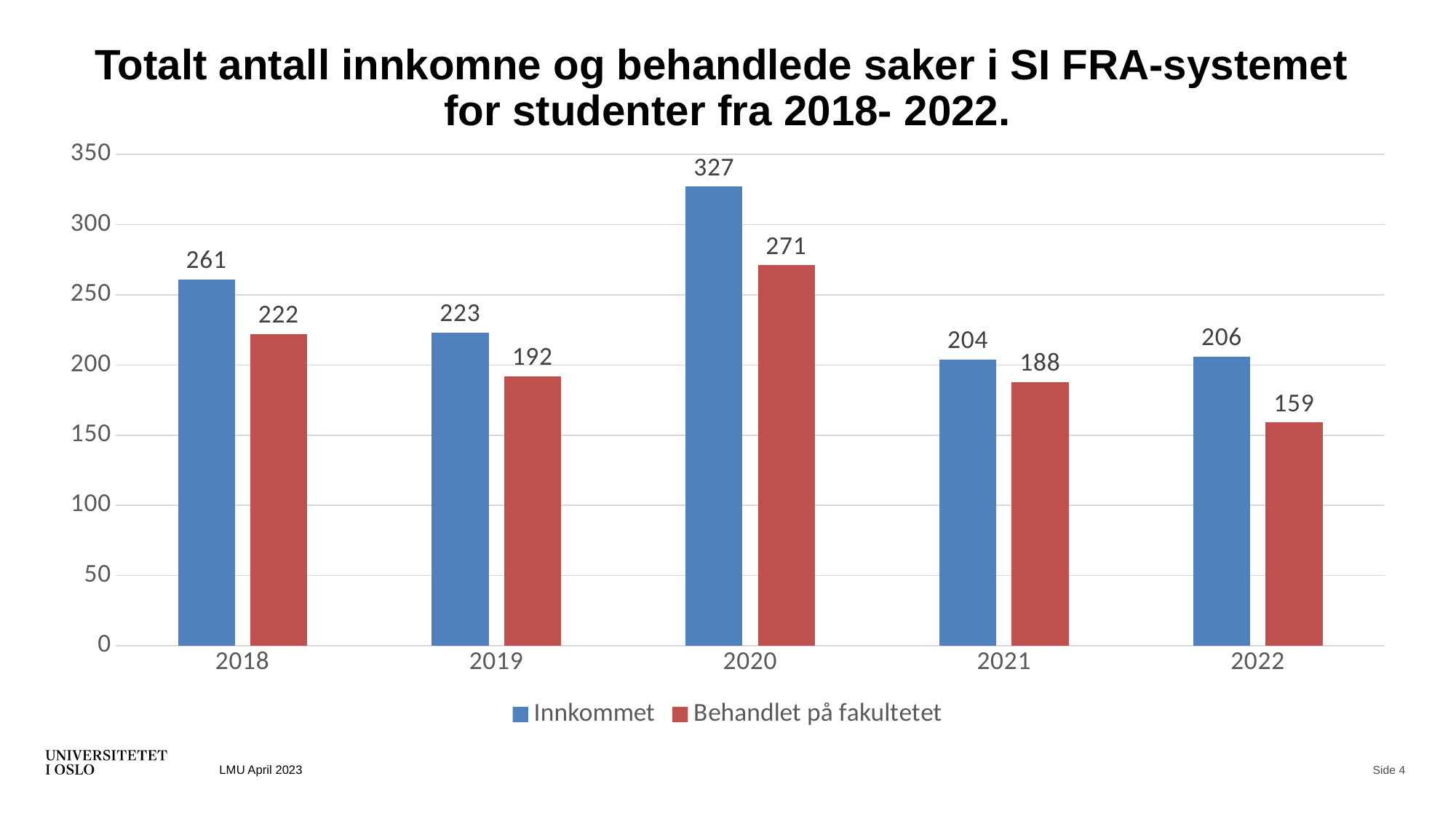
What is the difference between Innkommet and Behandlet på fakultetet in 2020? 56 Which year has the highest Innkommet value? 2020 Which colour represents the Innkommet series? Blue What is the value for Behandlet på fakultetet in 2018? 222 Which is larger: Innkommet in 2018 or Innkommet in 2019? Innkommet in 2018 What is the value for Innkommet in 2020? 327 Is the value for Behandlet på fakultetet in 2021 greater or less than 200? less What kind of chart is shown on the slide? Bar chart How many series does the legend list? 2 What is the value for Behandlet på fakultetet in 2022? 159 How many years are shown on the x axis? 5 Which year has the lowest Behandlet på fakultetet value? 2022